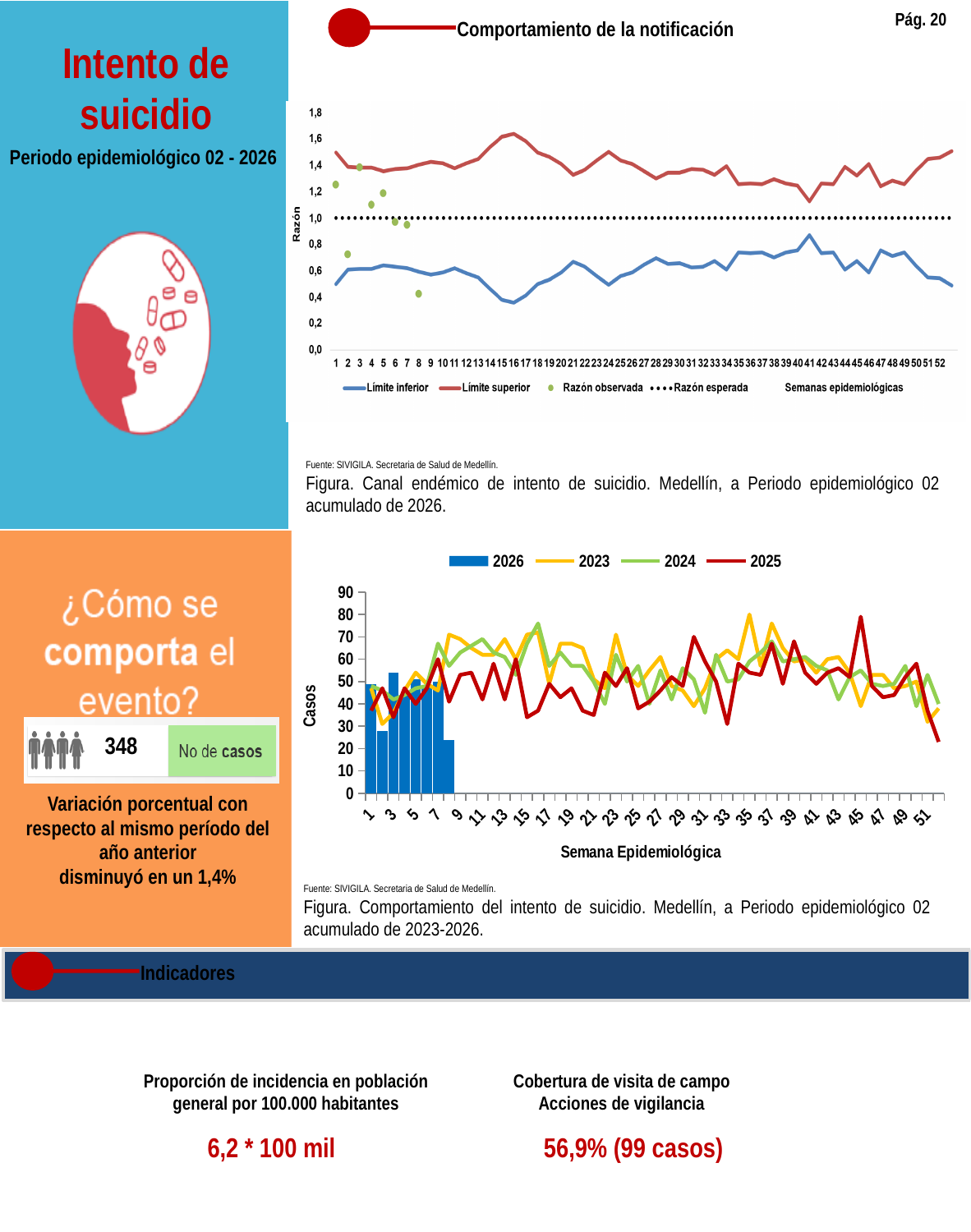
In the top chart (Canal endémico), is the Razón observada value at week 2 greater or less than 1,0? less In the top chart (Canal endémico), what is the label of the vertical axis? Razón In the top chart (Canal endémico), what kind of chart is it? line chart In the top chart (Canal endémico), what is the value of the Razón esperada line? 1,0 In the top chart (Canal endémico), is the Razón observada value at week 8 greater or less than 0,6? less In the bottom chart (Comportamiento del intento de suicidio), which series is drawn as bars? 2026 In the top chart (Canal endémico), how many series does the legend list? 4 In the top chart (Canal endémico), is the Límite superior value at week 16 greater or less than 1,4? greater In the bottom chart (Comportamiento del intento de suicidio), how many series does the legend list? 4